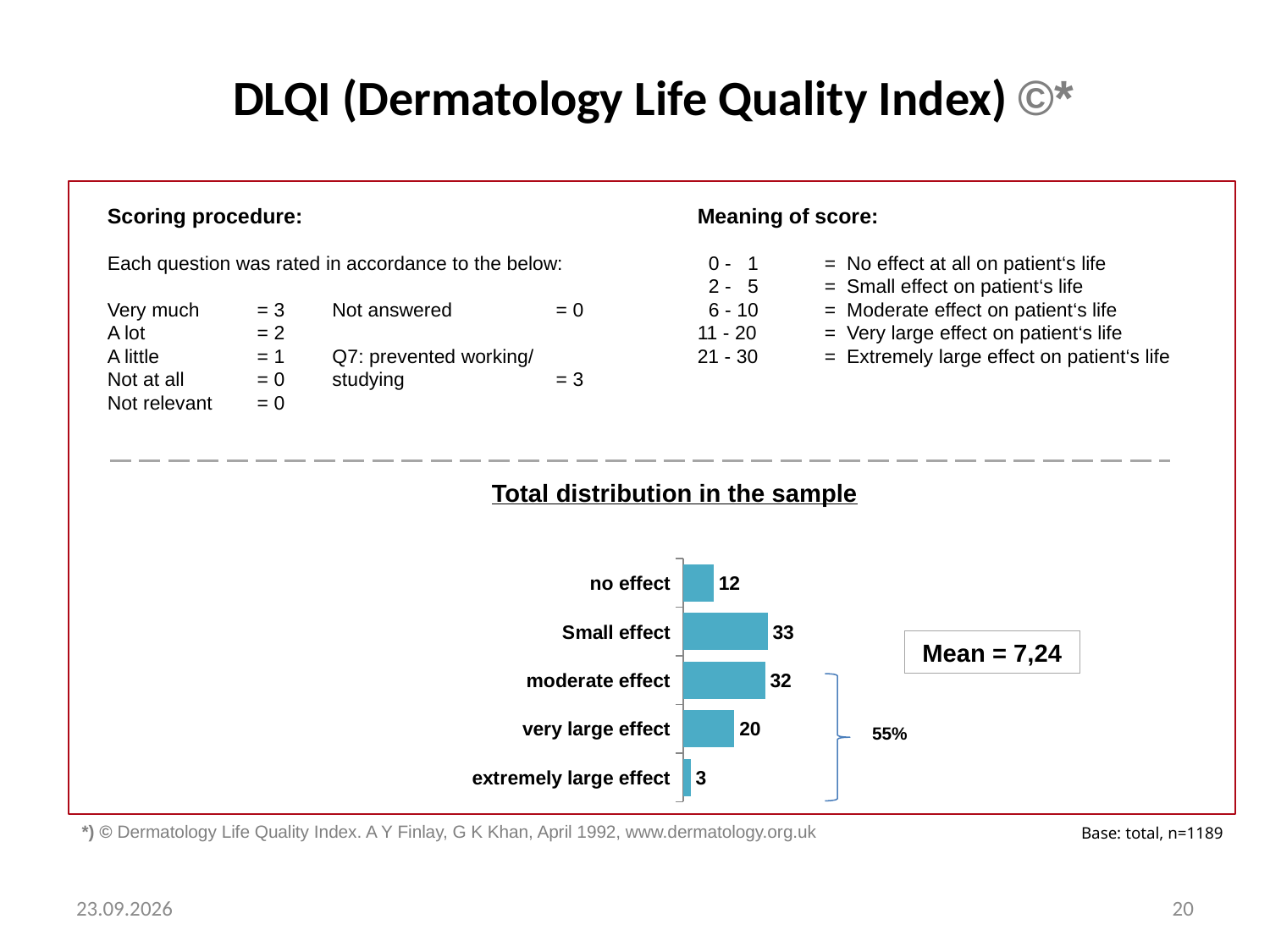
How many categories are shown in the Total distribution in the sample chart? 5 What kind of chart is the Total distribution in the sample chart? bar chart What is the value for "very large effect" in the Total distribution in the sample chart? 20 What is the difference between the values for "Small effect" and "moderate effect" in the Total distribution in the sample chart? 1 What is the value for "Small effect" in the Total distribution in the sample chart? 33 What is the value for "extremely large effect" in the Total distribution in the sample chart? 3 Which category has the lowest value in the Total distribution in the sample chart? extremely large effect Which is larger in the Total distribution in the sample chart: the value for "no effect" or the value for "very large effect"? very large effect What is the difference between the values for "very large effect" and "extremely large effect" in the Total distribution in the sample chart? 17 What mean value is shown next to the Total distribution in the sample chart? Mean = 7,24 Which category has the highest value in the Total distribution in the sample chart? Small effect What is the value for "no effect" in the Total distribution in the sample chart? 12